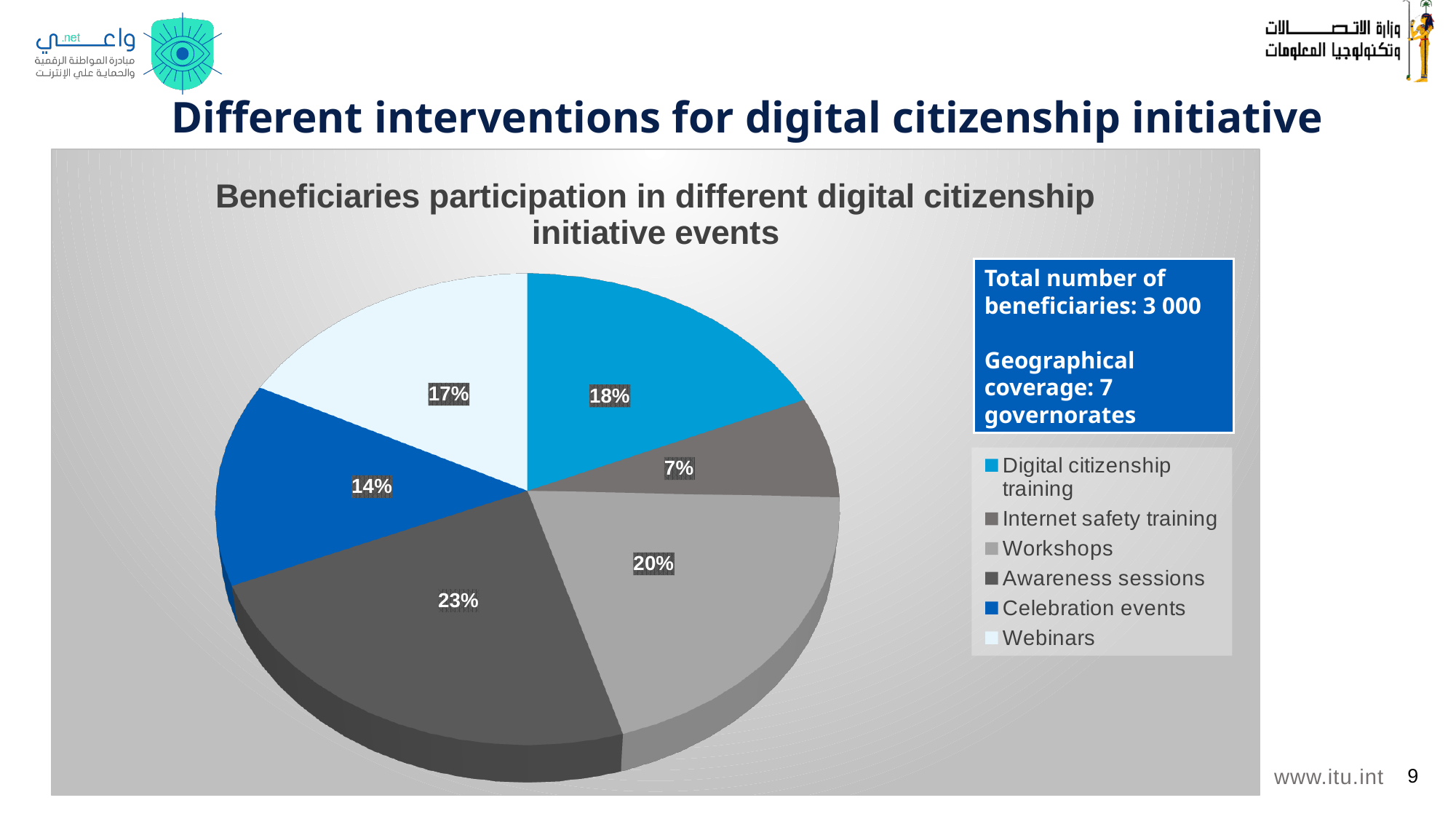
What share of the pie does Internet safety training represent? 7% What is the difference in percentage points between Awareness sessions and Internet safety training? 16 What share of the pie does Celebration events represent? 14% What kind of chart is shown on the slide? Pie chart What share of the pie does Awareness sessions represent? 23% Which category has the largest share of the pie? Awareness sessions Which is larger, the share for Workshops or the share for Webinars? Workshops How many categories does the legend list? 6 Which category has the smallest share of the pie? Internet safety training